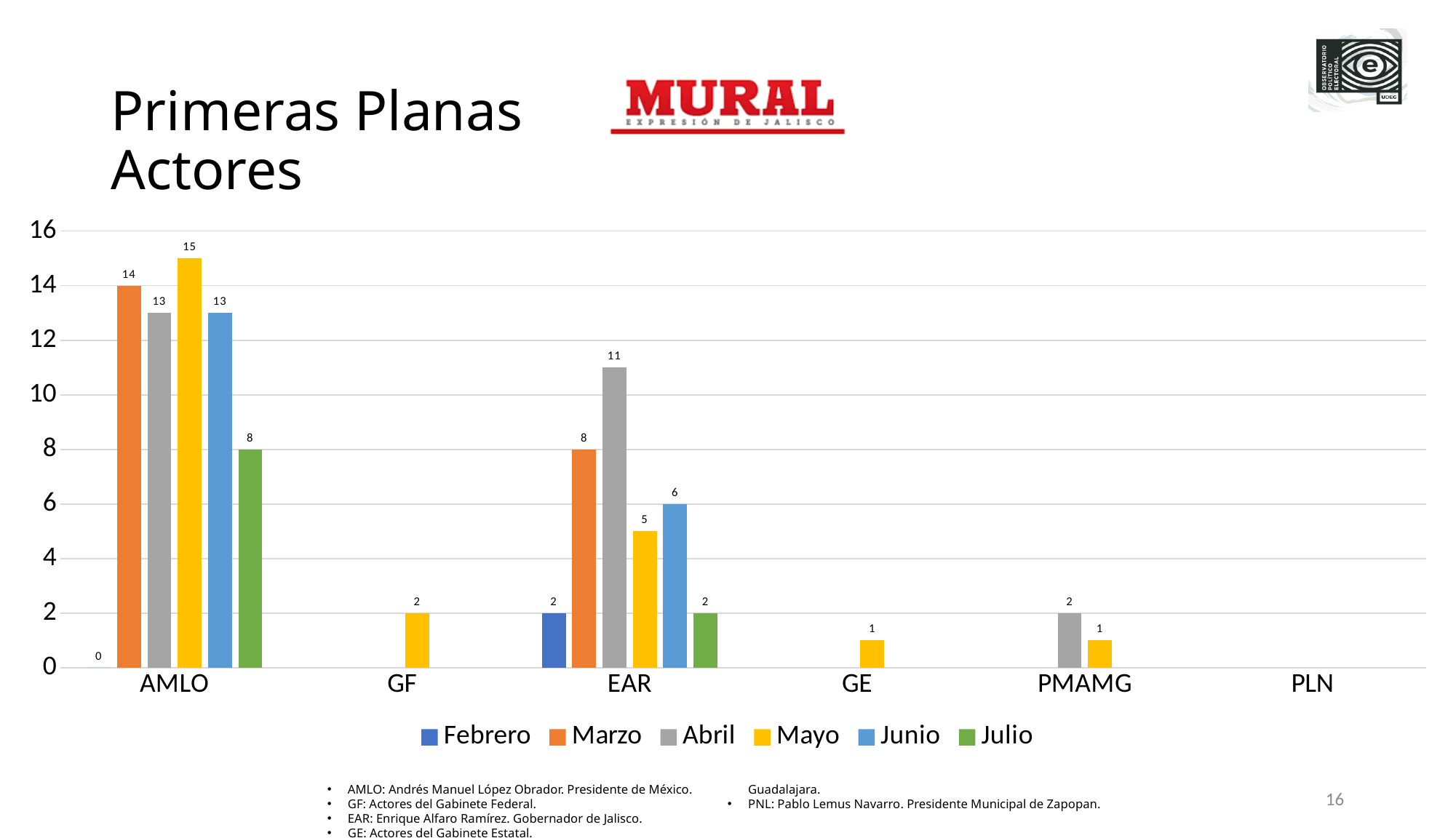
How many series does the legend list? 6 Which month has the highest value for AMLO? Mayo What is the value for AMLO in Mayo? 15 How many categories are shown on the x axis? 6 Which is larger, the Junio value for AMLO or the Junio value for EAR? AMLO What is the value for PMAMG in Abril? 2 What is the value for AMLO in Febrero? 0 What kind of chart is shown on the slide? Bar chart What is the difference between the Marzo values for AMLO and EAR? 6 Which colour represents Mayo in the legend? Yellow What is the value for EAR in Abril? 11 Which month has the lowest value for EAR? Febrero and Julio